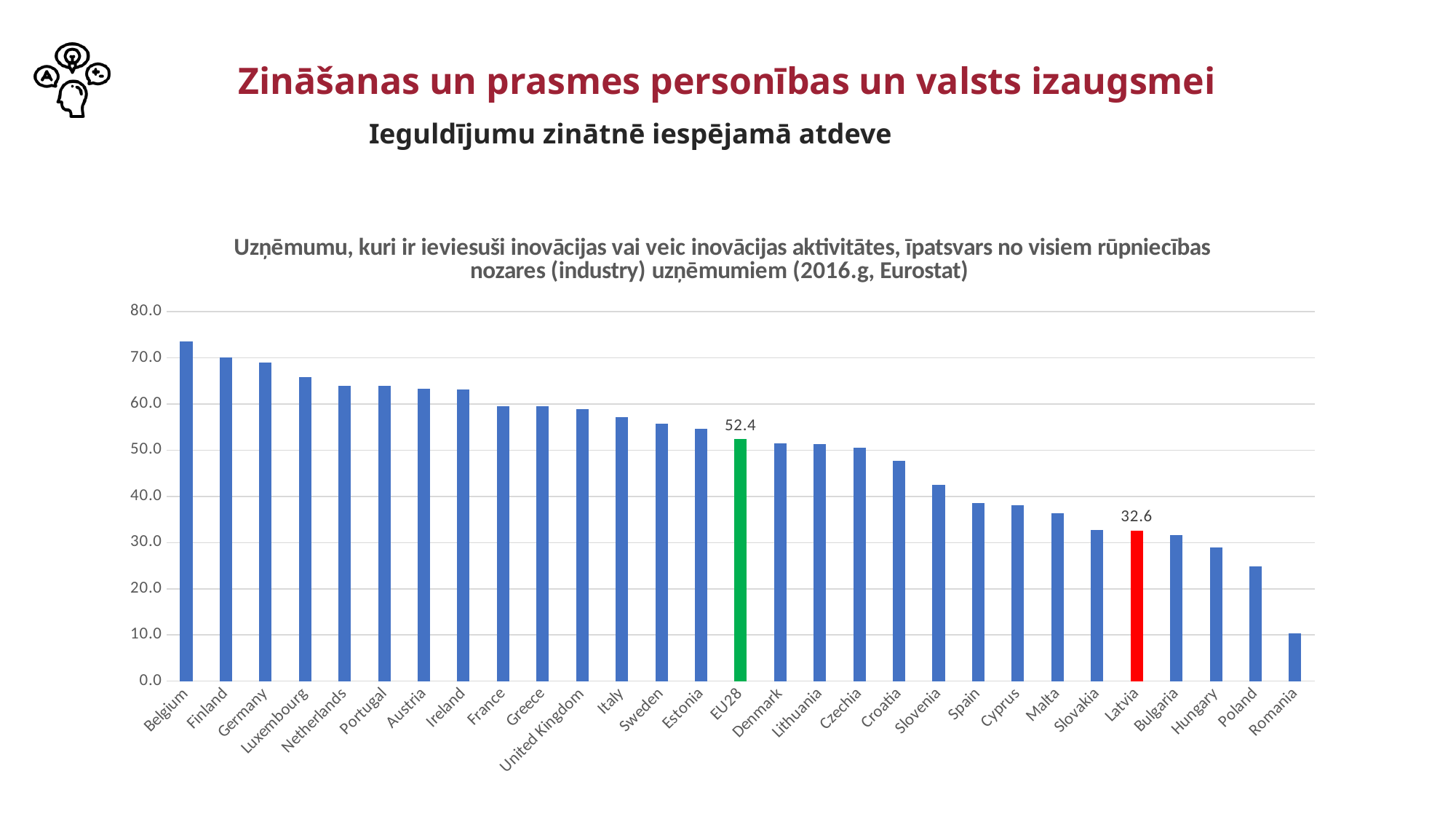
Is the value for Belgium greater or less than 70.0? greater Which bar is coloured red in the chart? Latvia Which country has the lowest bar in the chart? Romania What kind of chart is shown on the slide? Bar chart Which country has the highest bar in the chart? Belgium What is the difference between the EU28 value and the Latvia value? 19.8 Is the value for Romania greater or less than 20.0? less How many bars (countries and EU28) are shown in the chart? 29 What is the value shown for EU28? 52.4 Is the value for Germany greater or less than 60.0? greater Which has a larger value, Finland or Poland? Finland What is the value shown for Latvia? 32.6